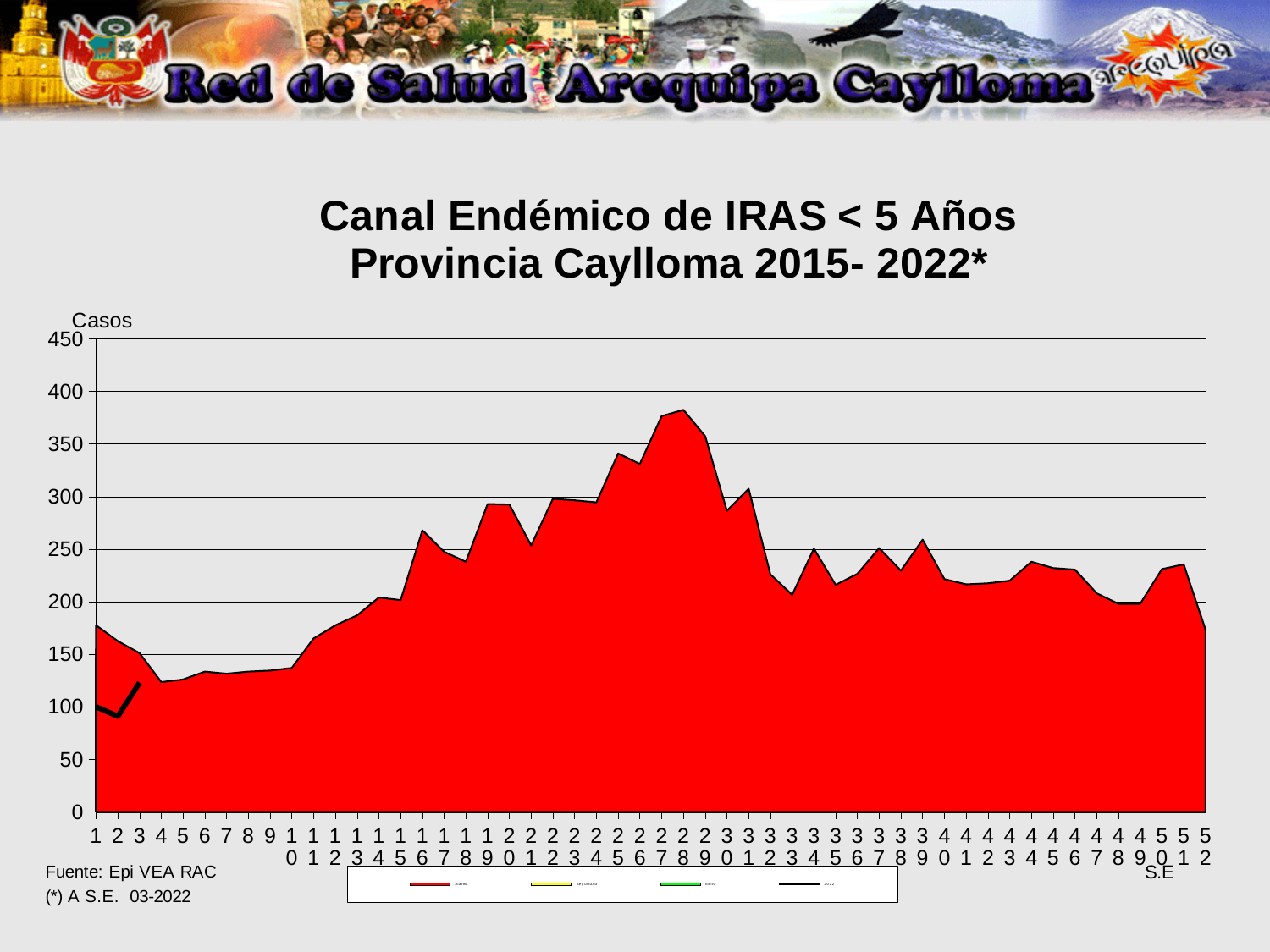
What is the label of the y axis? Casos Is the value of the red area at week 1 greater or less than 150? greater Is the value of the red area at week 28 greater or less than 350? greater Is the value of the red area at week 4 greater or less than 150? less What is the title of the chart? Canal Endémico de IRAS < 5 Años Provincia Caylloma 2015- 2022* How many series does the legend list? 4 Does the red area rise or fall from week 20 to week 28? rise Does the red area rise or fall from week 28 to week 33? fall What kind of chart is shown on the slide? Area and line chart How many epidemiological weeks (S.E.) are shown along the x axis? 52